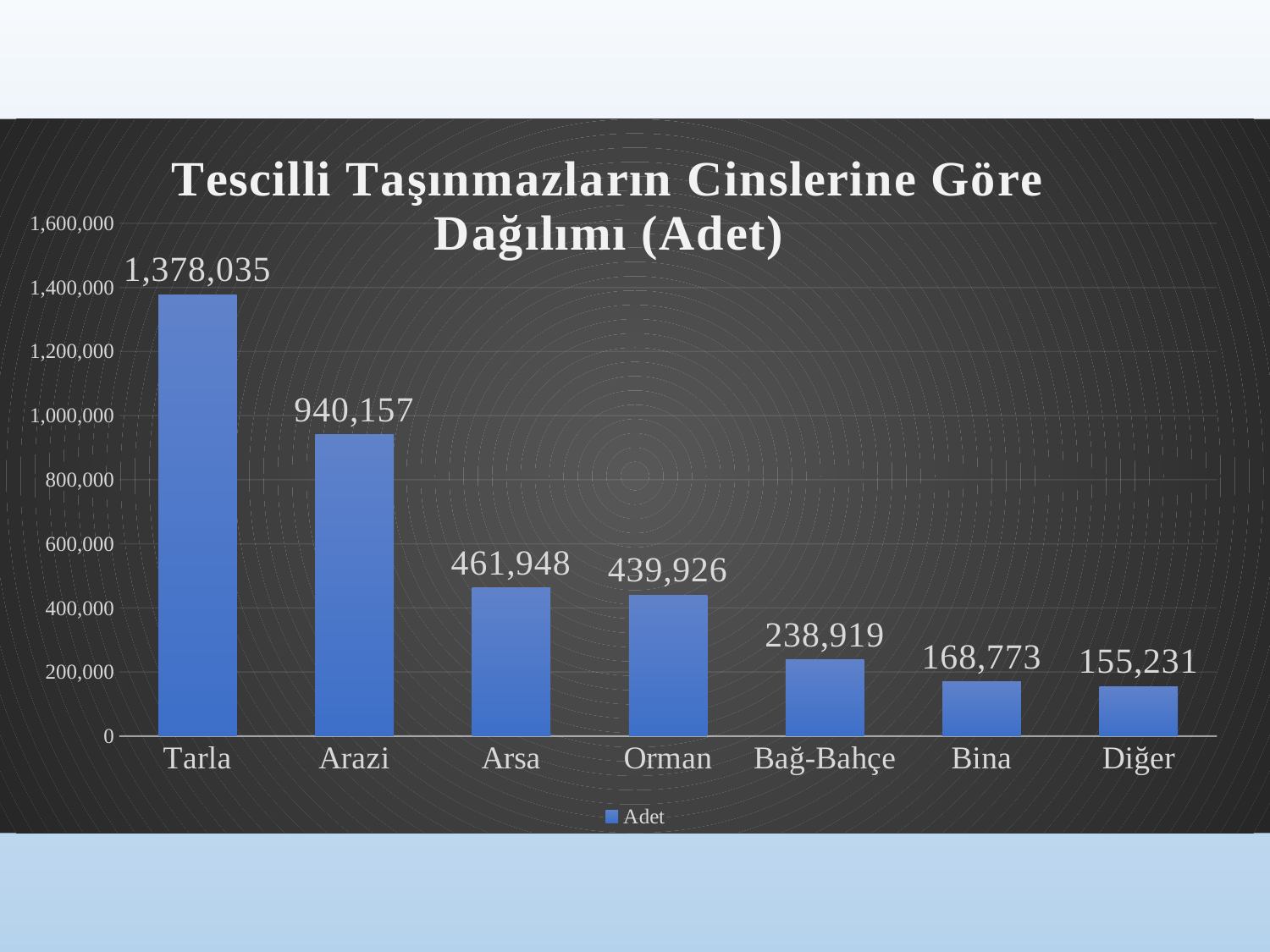
How many categories are shown on the x axis? 7 What is the value for Orman? 439,926 What is the difference between the values for Arsa and Orman? 22,022 What is the value for Bina? 168,773 What is the difference between the values for Tarla and Arazi? 437,878 What is the name of the series shown in the legend? Adet Which is larger, the value for Bağ-Bahçe or the value for Bina? Bağ-Bahçe How many series does the legend list? 1 What is the value for Tarla? 1,378,035 Which category has the highest value? Tarla Which category has the lowest value? Diğer What kind of chart is shown on the slide? bar chart